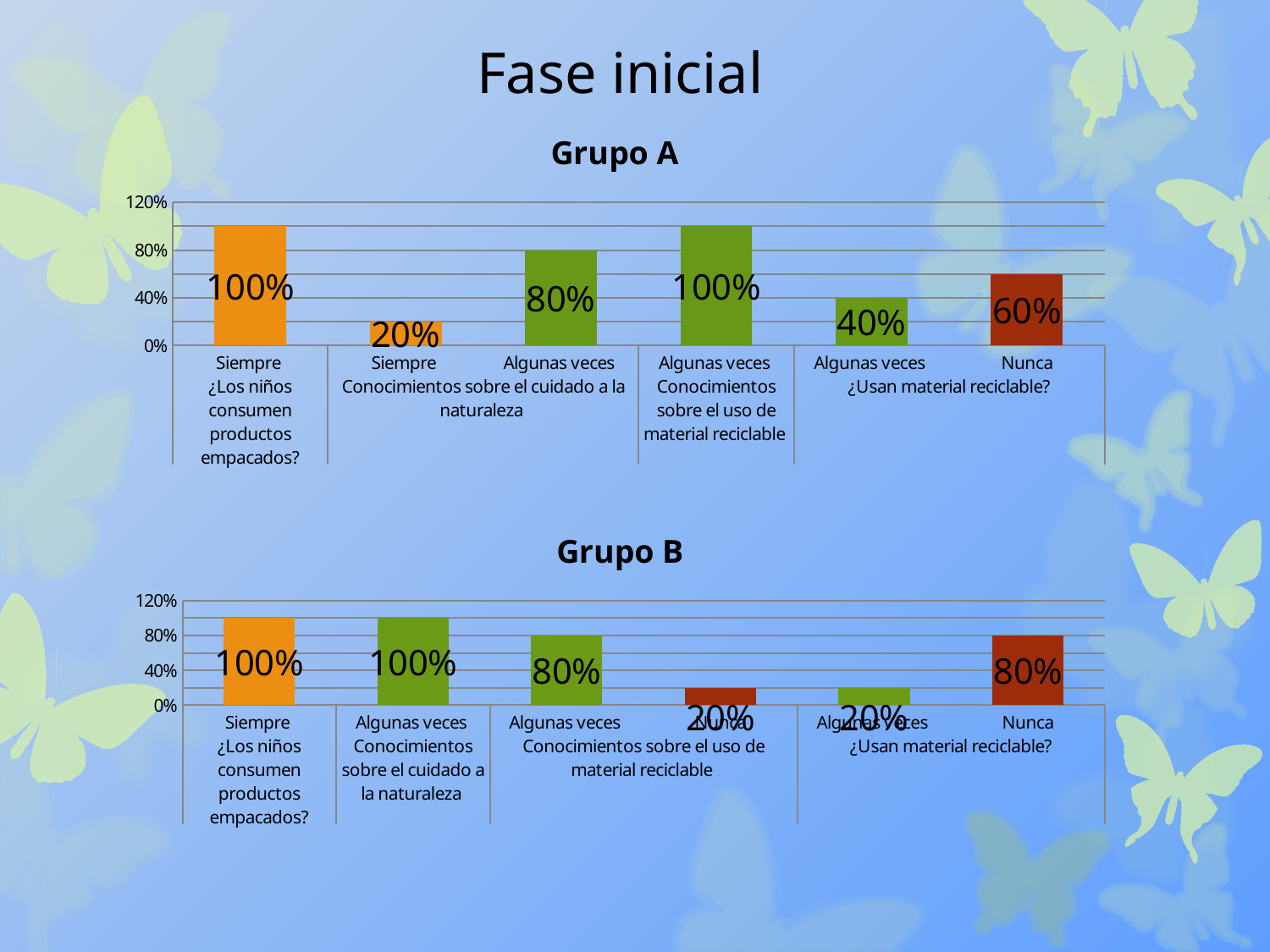
In the Grupo B chart, what is the value for "Algunas veces" under "Conocimientos sobre el uso de material reciclable"? 80% In the Grupo A chart, what is the value for "Algunas veces" under "¿Usan material reciclable?"? 40% In the Grupo A chart, what is the value for "Nunca" under "¿Usan material reciclable?"? 60% What kind of chart is the Grupo A chart? Bar chart In the Grupo A chart, what is the value for "Siempre" under "Conocimientos sobre el cuidado a la naturaleza"? 20% In the Grupo A chart, what is the difference between "Nunca" and "Algunas veces" under "¿Usan material reciclable?"? 20% In the Grupo B chart, what is the value for "Algunas veces" under "Conocimientos sobre el cuidado a la naturaleza"? 100% In the Grupo B chart, which is larger: "Algunas veces" or "Nunca" under "¿Usan material reciclable?"? Nunca In the Grupo A chart, which category has the lowest value? Siempre (Conocimientos sobre el cuidado a la naturaleza) How many bars are plotted in the Grupo B chart? 6 In the Grupo B chart, what is the value for "Nunca" under "¿Usan material reciclable?"? 80% What is the title of the lower chart on the slide? Grupo B